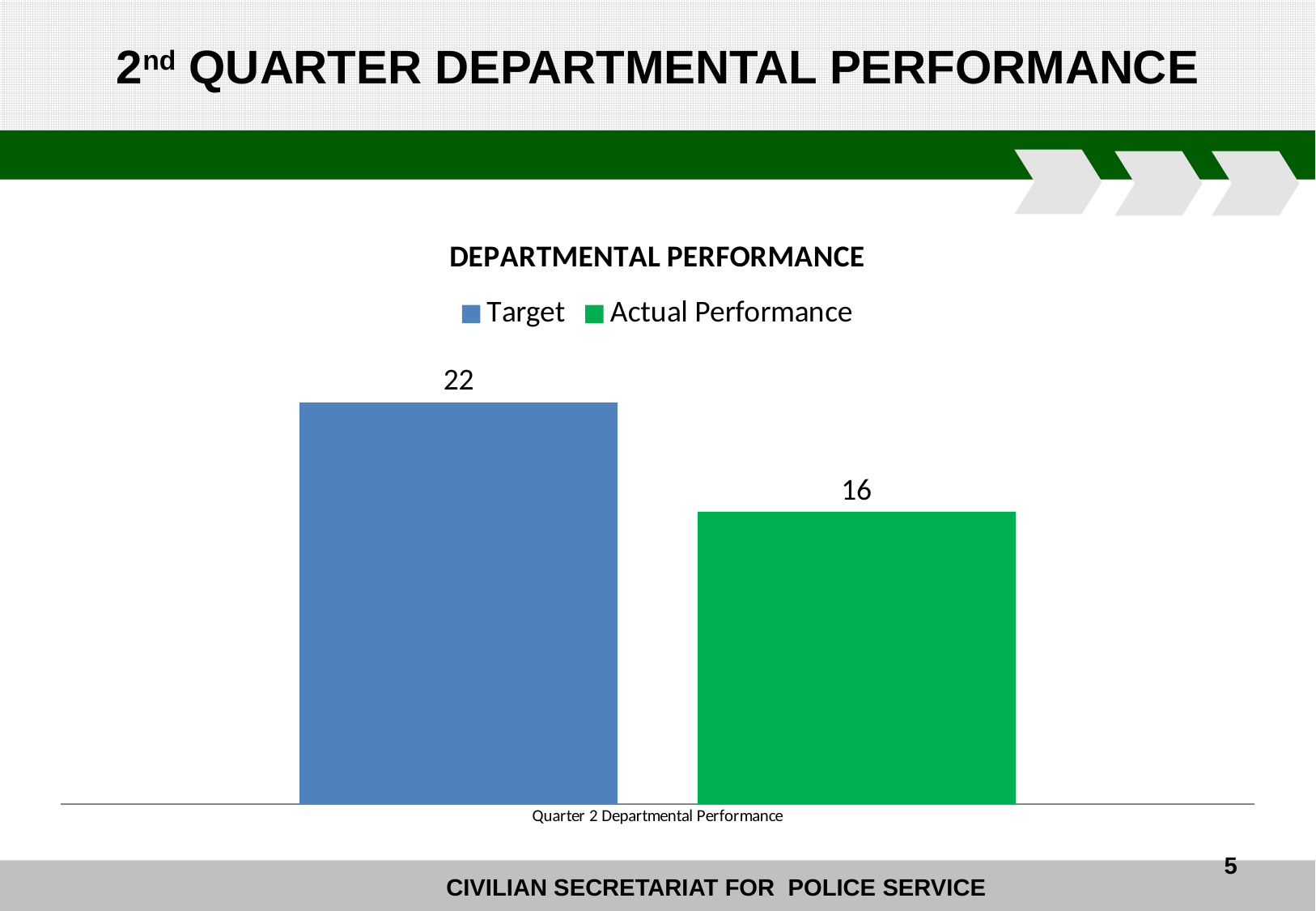
What is the category label shown on the x axis? Quarter 2 Departmental Performance Which bar is the highest on the chart? Target What is the title of the chart? DEPARTMENTAL PERFORMANCE What is the value of the Actual Performance bar? 16 How many bars are plotted on the chart? 2 Which bar is the lowest on the chart? Actual Performance What kind of chart is shown on the slide? Bar chart How many series does the legend list? 2 What is the difference between the Target and Actual Performance values? 6 Which series has the higher value, Target or Actual Performance? Target What colour is the Actual Performance bar? Green What is the value of the Target bar? 22